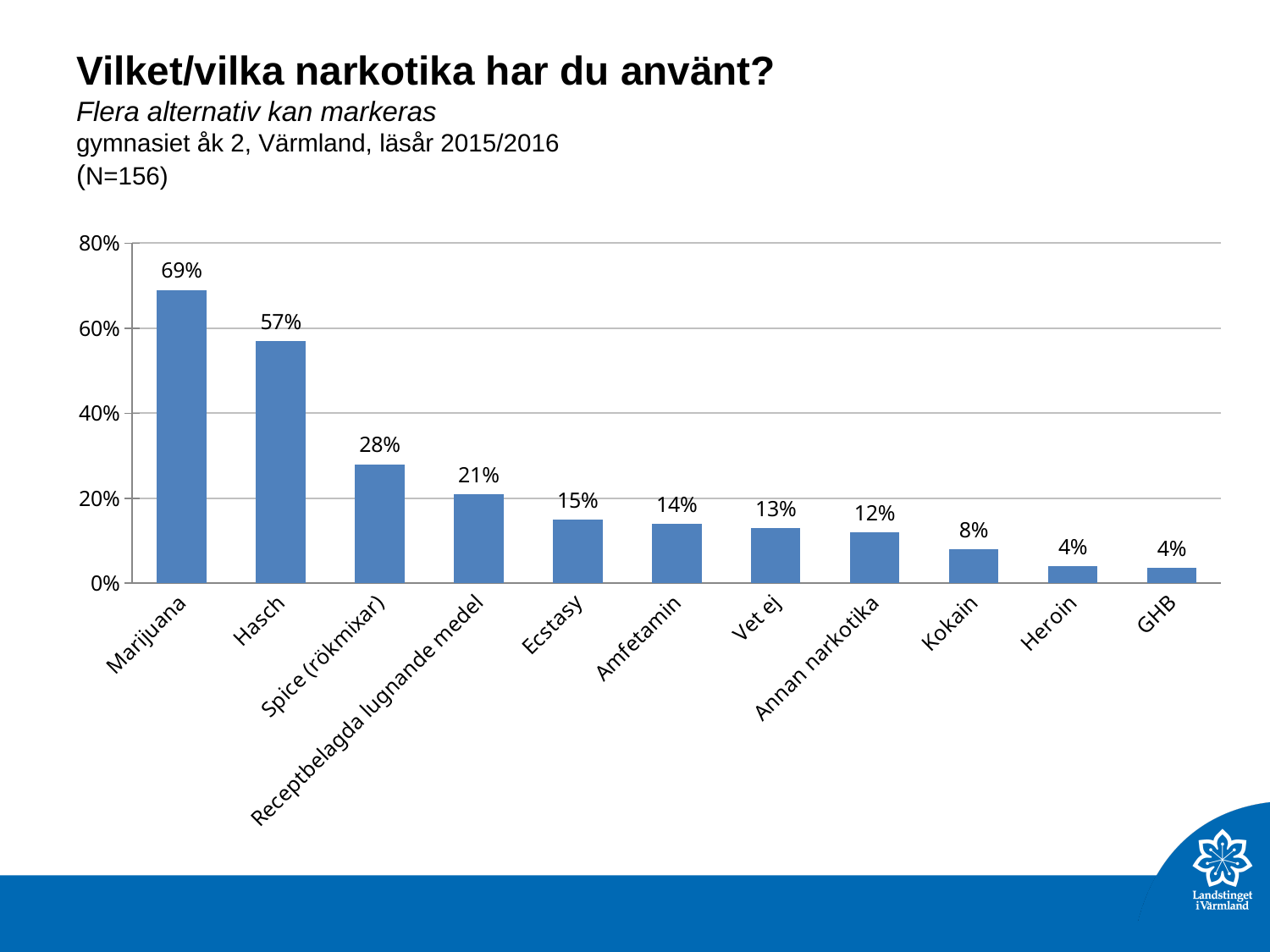
What is the difference between the values for Marijuana and Hasch? 12% Which is larger, the value for Ecstasy or the value for Amfetamin? Ecstasy What is the value for Spice (rökmixar)? 28% What is the value for Kokain? 8% Do the values rise or fall from left to right along the x axis? fall What is the value for Receptbelagda lugnande medel? 21% What is the sample size (N) stated on the slide? 156 Is the value for Hasch greater or less than 40%? greater How many categories are shown on the x axis? 11 Which category has the highest value? Marijuana What is the value for Marijuana? 69% What kind of chart is shown on the slide? bar chart